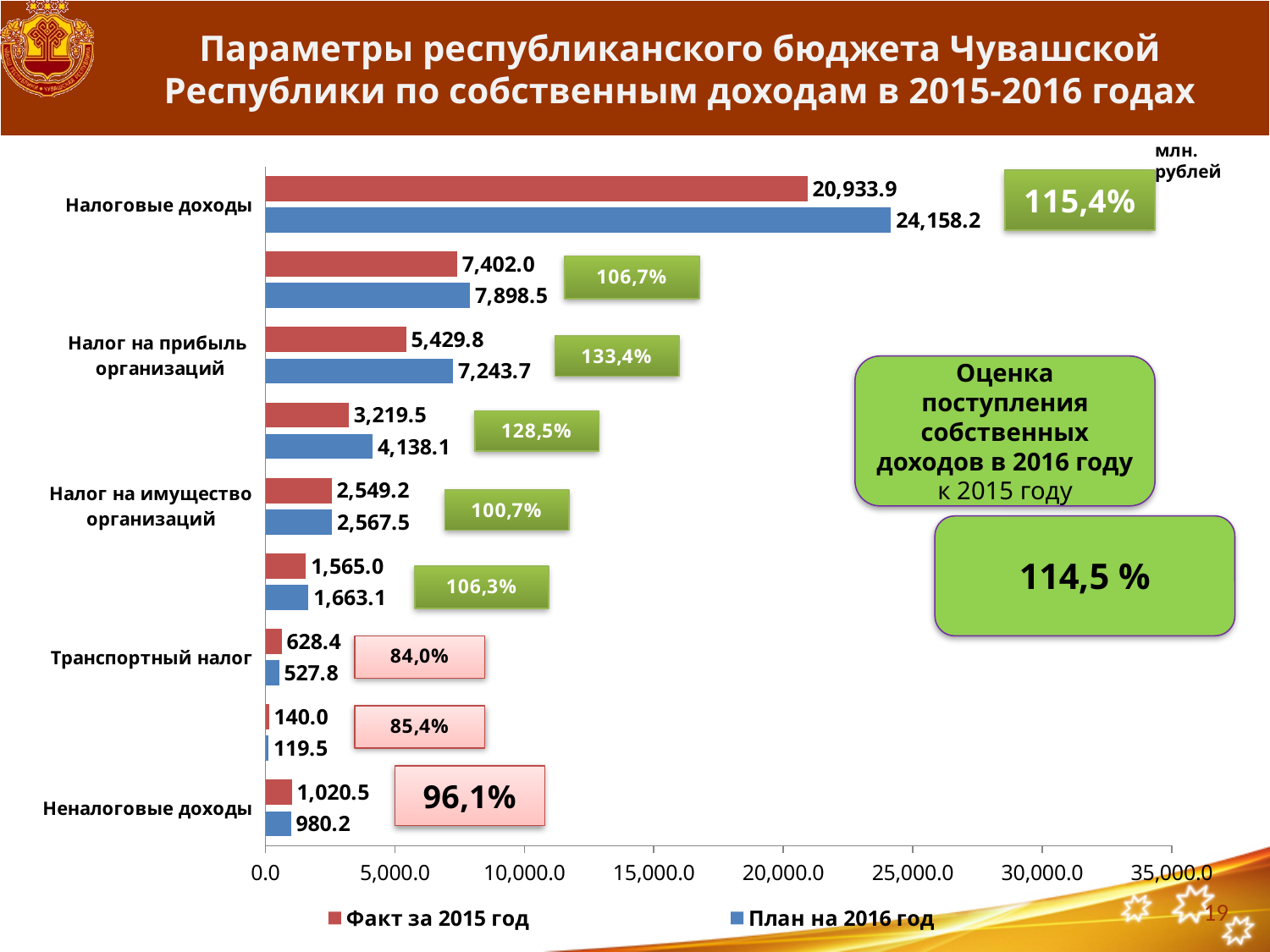
What kind of chart is shown on the slide? bar chart By how much does План на 2016 год exceed Факт за 2015 год for Налоговые доходы? 3,224.3 What is the value of Факт за 2015 год for Транспортный налог? 628.4 Is the value of План на 2016 год for Налог на прибыль организаций greater or less than 5,000.0? greater What is the value of План на 2016 год for Налог на прибыль организаций? 7,243.7 How many series does the legend list? 2 What is the value of План на 2016 год for Неналоговые доходы? 980.2 What is the value of План на 2016 год for Налоговые доходы? 24,158.2 Which category has the highest value for План на 2016 год? Налоговые доходы For Транспортный налог, which is larger: Факт за 2015 год or План на 2016 год? Факт за 2015 год What is the value of Факт за 2015 год for Налоговые доходы? 20,933.9 What is the difference between План на 2016 год and Факт за 2015 год for Налог на имущество организаций? 18.3